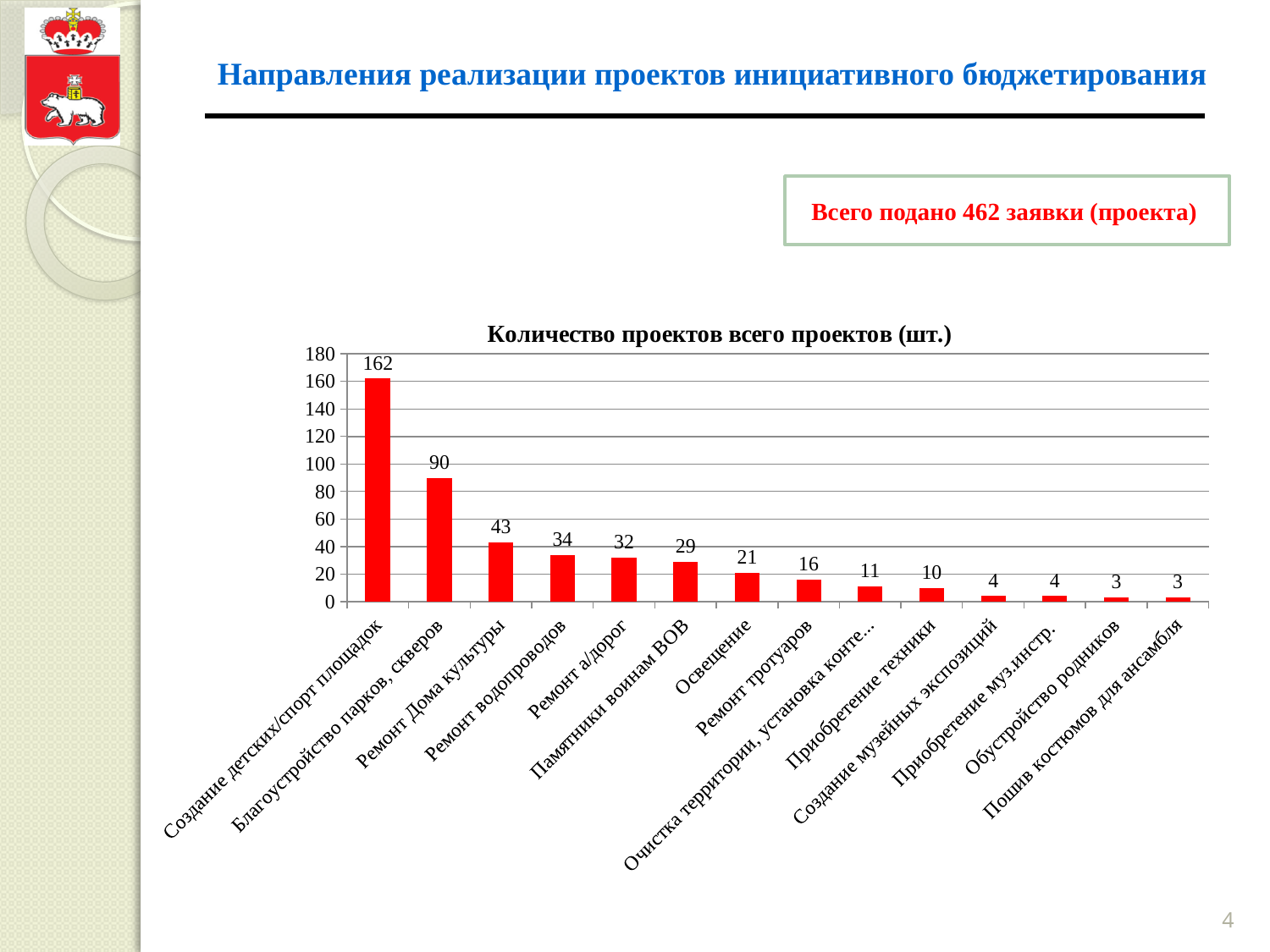
Which is larger, the value for "Ремонт водопроводов" or the value for "Ремонт а/дорог"? Ремонт водопроводов Which category has the highest value? Создание детских/спорт площадок What type of chart is shown on the slide? bar chart What is the value for "Ремонт Дома культуры"? 43 How many categories are shown on the x axis of the chart? 14 What is the value for "Освещение"? 21 What is the value for "Приобретение техники"? 10 What is the value for "Создание детских/спорт площадок"? 162 Do the values generally rise or fall from left to right along the x axis? fall What is the value for "Благоустройство парков, скверов"? 90 What is the difference between the values for "Создание детских/спорт площадок" and "Благоустройство парков, скверов"? 72 What is the title of the chart? Количество проектов всего проектов (шт.)